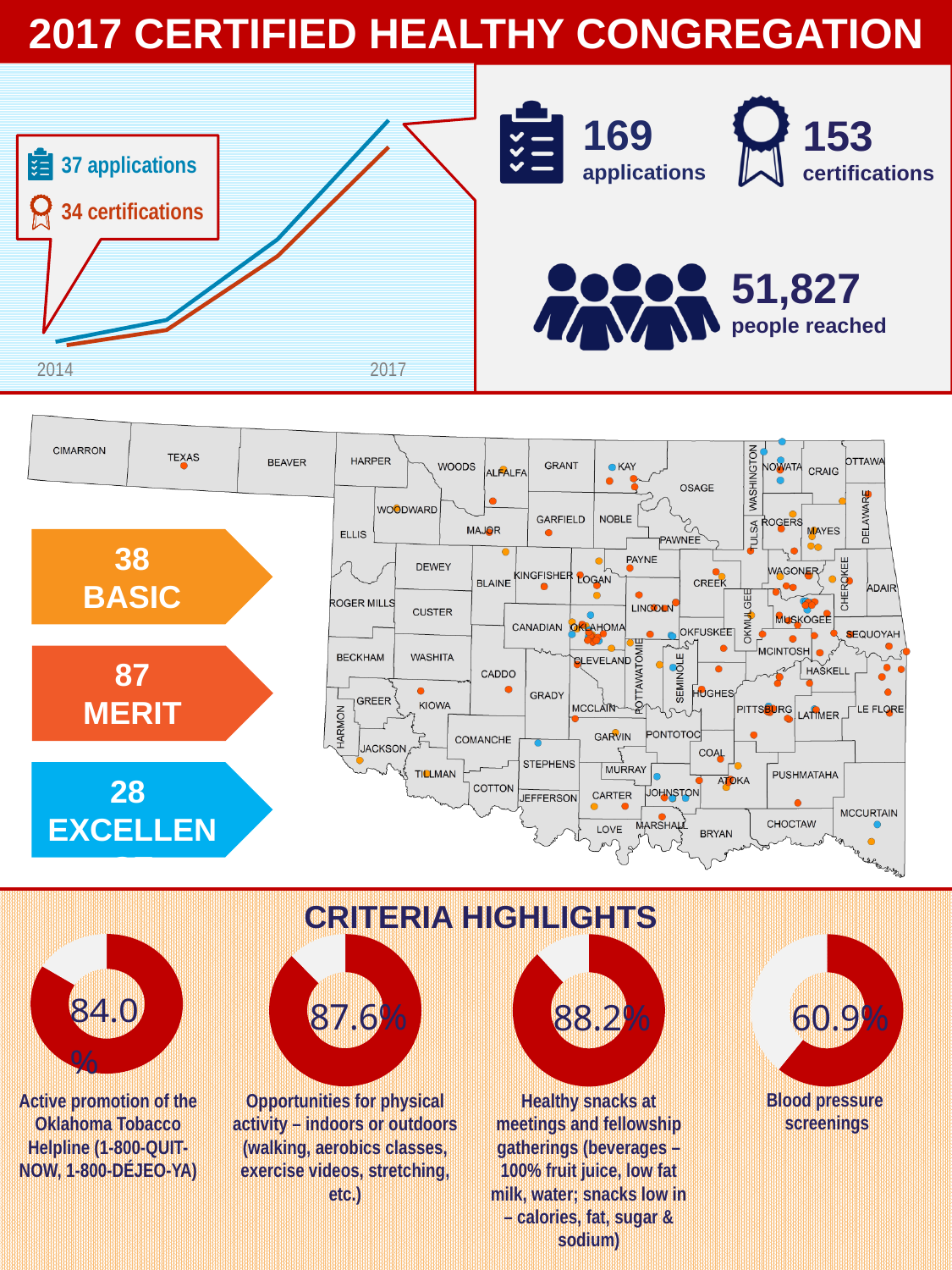
In the top-left line chart, how many lines (series) are plotted? 2 In the Criteria Highlights section, which criterion has the lowest percentage? Blood pressure screenings (60.9%) How many donut charts are shown in the Criteria Highlights section? 4 In the Criteria Highlights section, which criterion has the highest percentage? Healthy snacks at meetings and fellowship gatherings (88.2%) According to the callout on the top-left line chart, how many certifications were there in 2014? 34 certifications What kind of chart is shown in the top-left panel with the years 2014 and 2017 on the x axis? line chart Using the values shown on the slide, by how much did applications increase from 2014 (37) to 2017 (169)? 132 In the Criteria Highlights section, what percentage is shown for Blood pressure screenings? 60.9% In the top-left line chart, do the values rise or fall from 2014 to 2017? rise According to the callout on the top-left line chart, how many applications were there in 2014? 37 applications What kind of charts are used in the Criteria Highlights section? pie (donut) charts In the top-left line chart, which line is higher in 2017, applications or certifications? applications